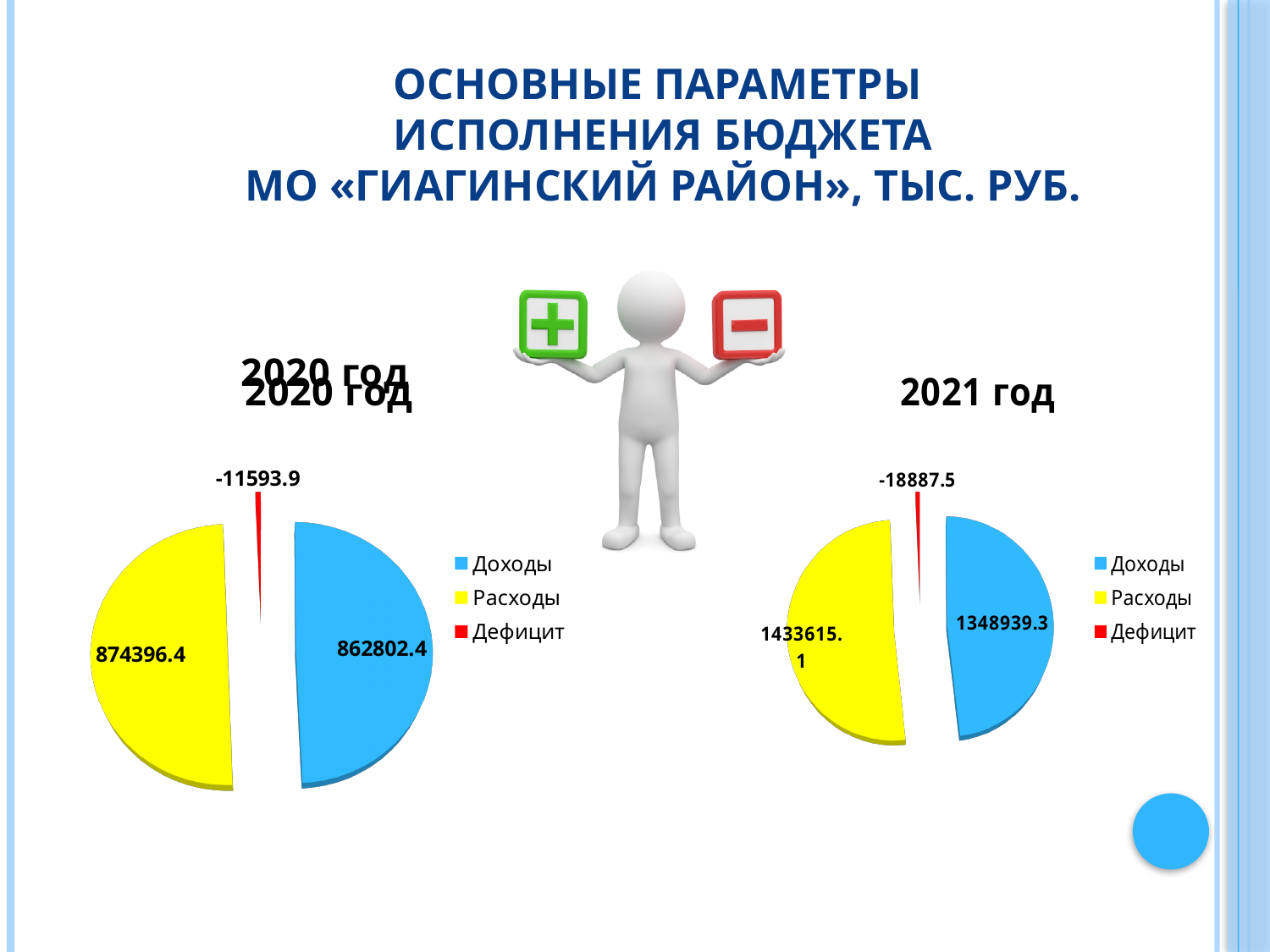
On the 2020 год chart, what is the value for Расходы? 874396.4 On the 2020 год chart, what is the value for Доходы? 862802.4 How many entries does the legend of the 2020 год chart list? 3 On the 2021 год chart, what is the difference between Расходы and Доходы? 84675.8 On the 2020 год chart, which category has the largest value? Расходы On the 2021 год chart, which is larger, Доходы or Расходы? Расходы On the 2020 год chart, what is the value for Дефицит? -11593.9 What type of chart is the 2021 год chart? Pie chart On the 2021 год chart, which colour represents Расходы? Yellow On the 2021 год chart, what is the value for Расходы? 1433615.1 On the 2021 год chart, what is the value for Дефицит? -18887.5 On the 2021 год chart, what is the value for Доходы? 1348939.3